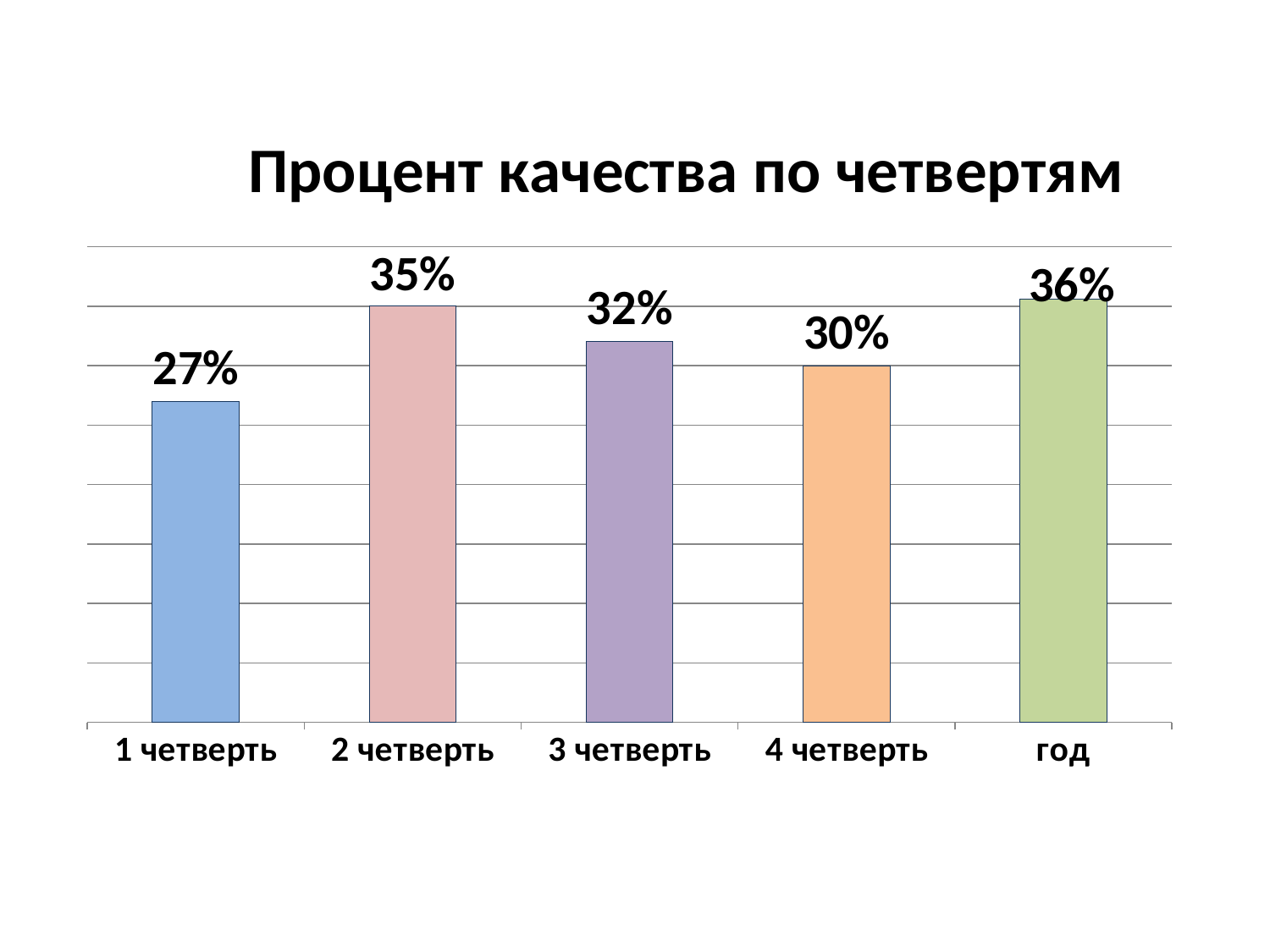
Which category has the lowest value? 1 четверть What kind of chart is this? bar chart What is the value for 4 четверть? 30% What is the value for год? 36% Which category has the highest value? год How many categories are shown on the x axis? 5 Which is larger, the value for 3 четверть or the value for 4 четверть? 3 четверть What is the value for 3 четверть? 32% What is the title of the chart? Процент качества по четвертям What is the value for 1 четверть? 27% What is the difference between the values for 2 четверть and 1 четверть? 8% What is the value for 2 четверть? 35%